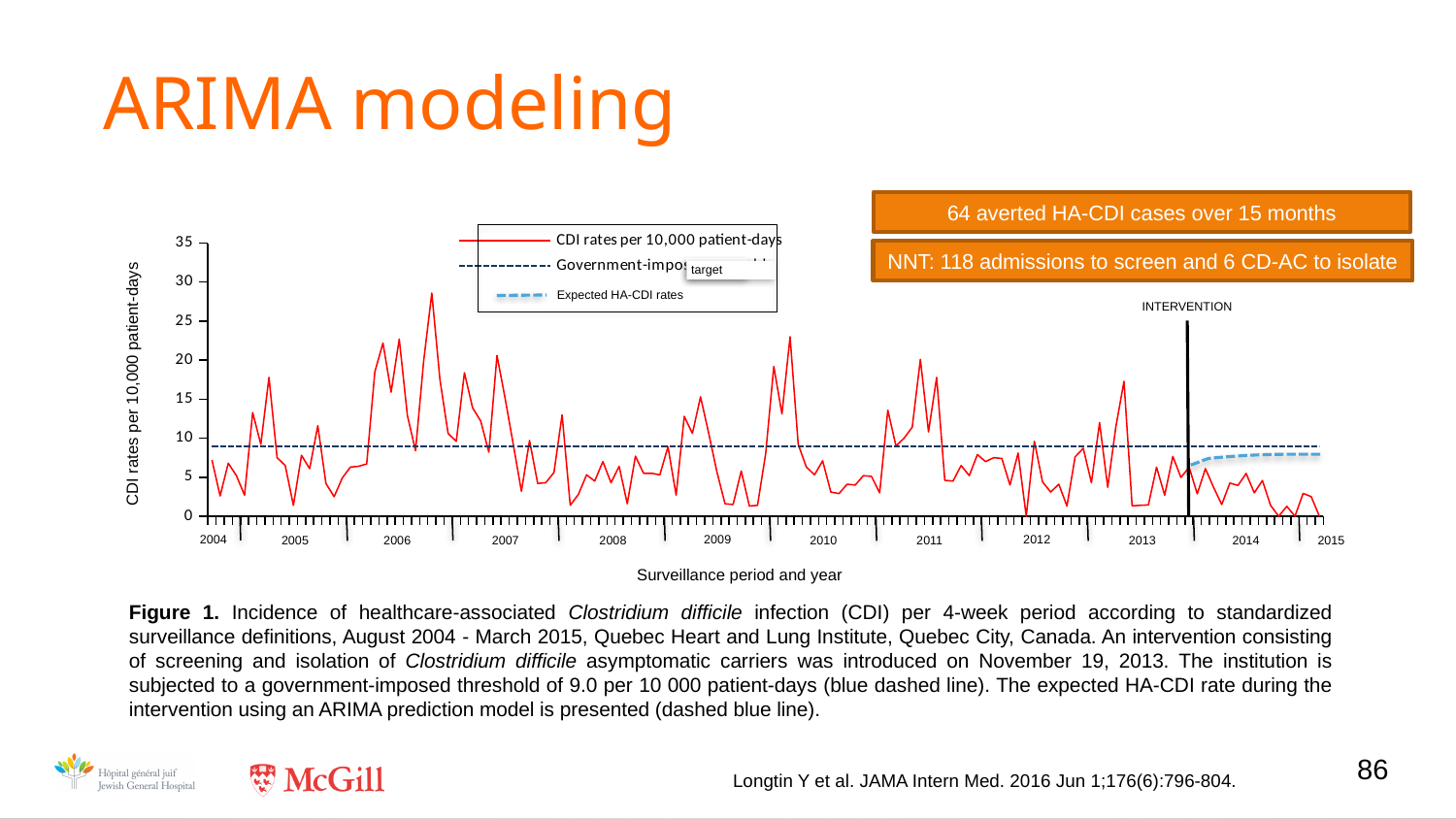
How many series does the chart legend list? 3 Which is higher on the chart: the peak of the CDI rates line in 2006 or the government-imposed target line? the peak of the CDI rates line in 2006 How many year labels are shown on the x axis of the chart? 12 Does the expected HA-CDI rates line rise or fall between the intervention in 2013 and 2015? rise Is the expected HA-CDI rate at the end of the chart, in 2015, greater or less than 10? less What does the vertical black line on the chart mark? INTERVENTION In which year does the CDI rates line reach its highest peak? 2006 What is the label of the y axis of the chart? CDI rates per 10,000 patient-days Is the highest peak of the CDI rates line, in 2006, greater or less than 25? greater What kind of chart is shown on the slide? line chart Is the CDI rate at the first point in 2004 greater or less than 10? less What is the value of the government-imposed threshold shown as the dashed line on the chart? 9.0 per 10 000 patient-days